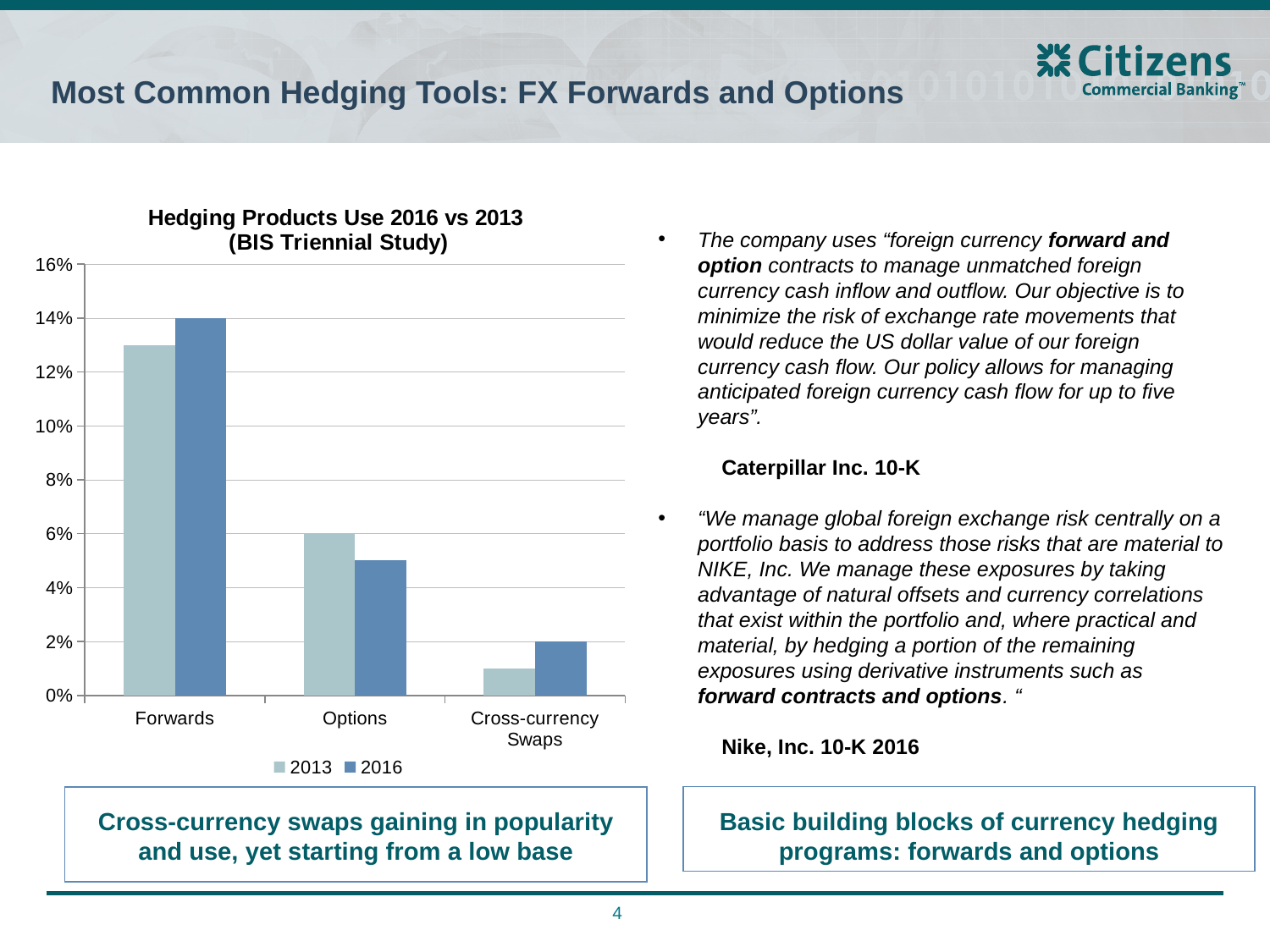
What is the title of the chart? Hedging Products Use 2016 vs 2013 (BIS Triennial Study) What is the 2013 value for Options? 6% How many categories are shown on the x axis of the chart? 3 Is the 2013 value for Forwards greater or less than 12%? greater How many series does the chart legend list? 2 Which category has the lowest value for 2013? Cross-currency Swaps What is the 2016 value for Cross-currency Swaps? 2% Is the 2016 value for Options greater or less than 6%? less Which category has the highest value for 2016? Forwards For Options, which series has the larger value, 2013 or 2016? 2013 What is the 2016 value for Forwards? 14% What type of chart is shown on the slide? Bar chart